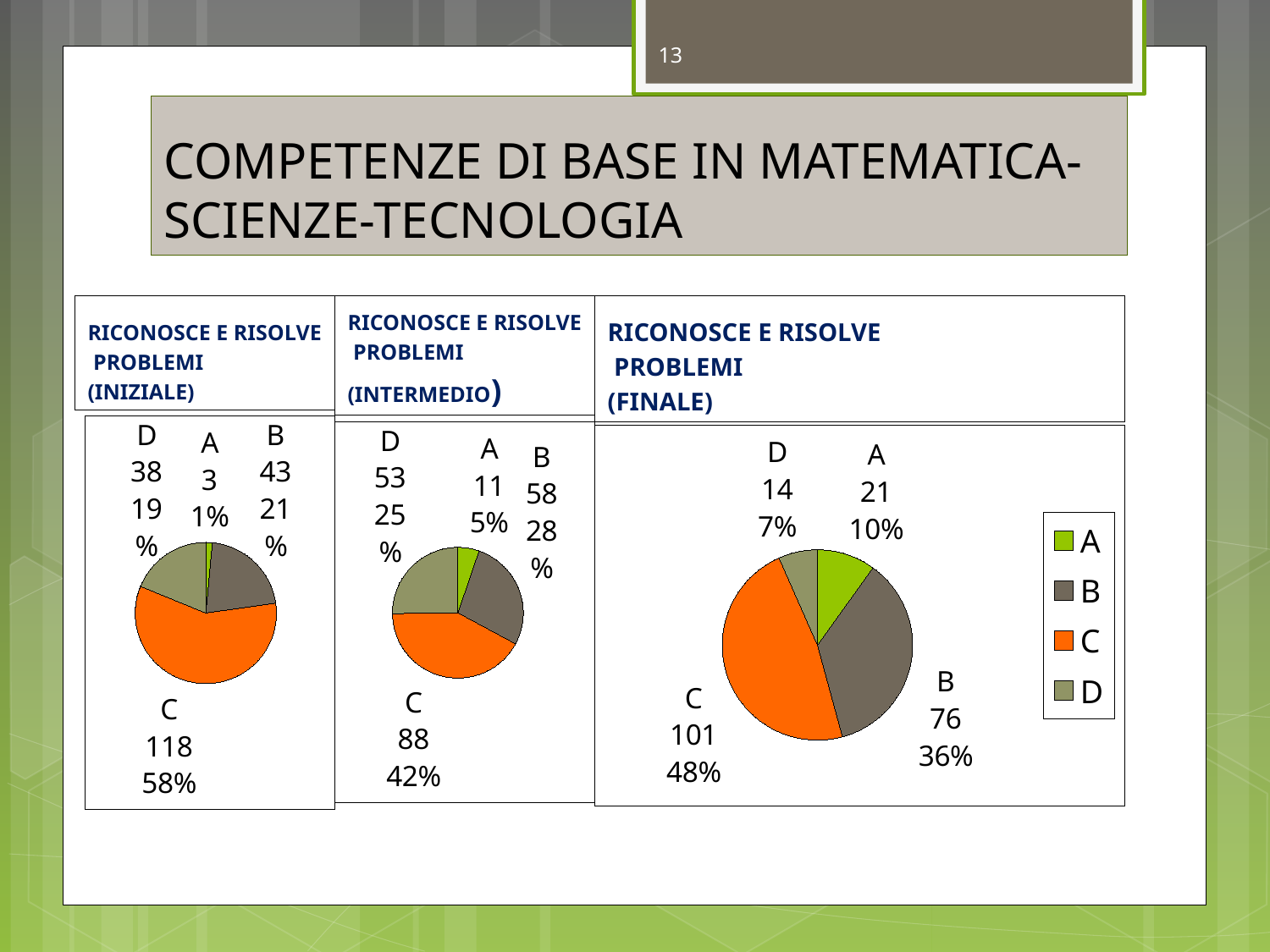
In the FINALE pie chart, what is the difference between the values for C and B? 25 In the INTERMEDIO pie chart, what is the difference between the values for B and D? 5 In the INIZIALE pie chart, what is the value for category C? 118 In the FINALE pie chart, which category has the largest value? C In the INTERMEDIO pie chart, what percentage share does category C have? 42% In the INIZIALE pie chart, which category has the smallest value? A In the FINALE pie chart, which is larger, the value for A or the value for D? A In the INIZIALE pie chart, what percentage share does category B have? 21% How many categories does the FINALE pie chart show? 4 In the FINALE pie chart, what is the value for category B? 76 What type of chart is used in the FINALE panel? Pie chart In the INTERMEDIO pie chart, what is the value for category D? 53